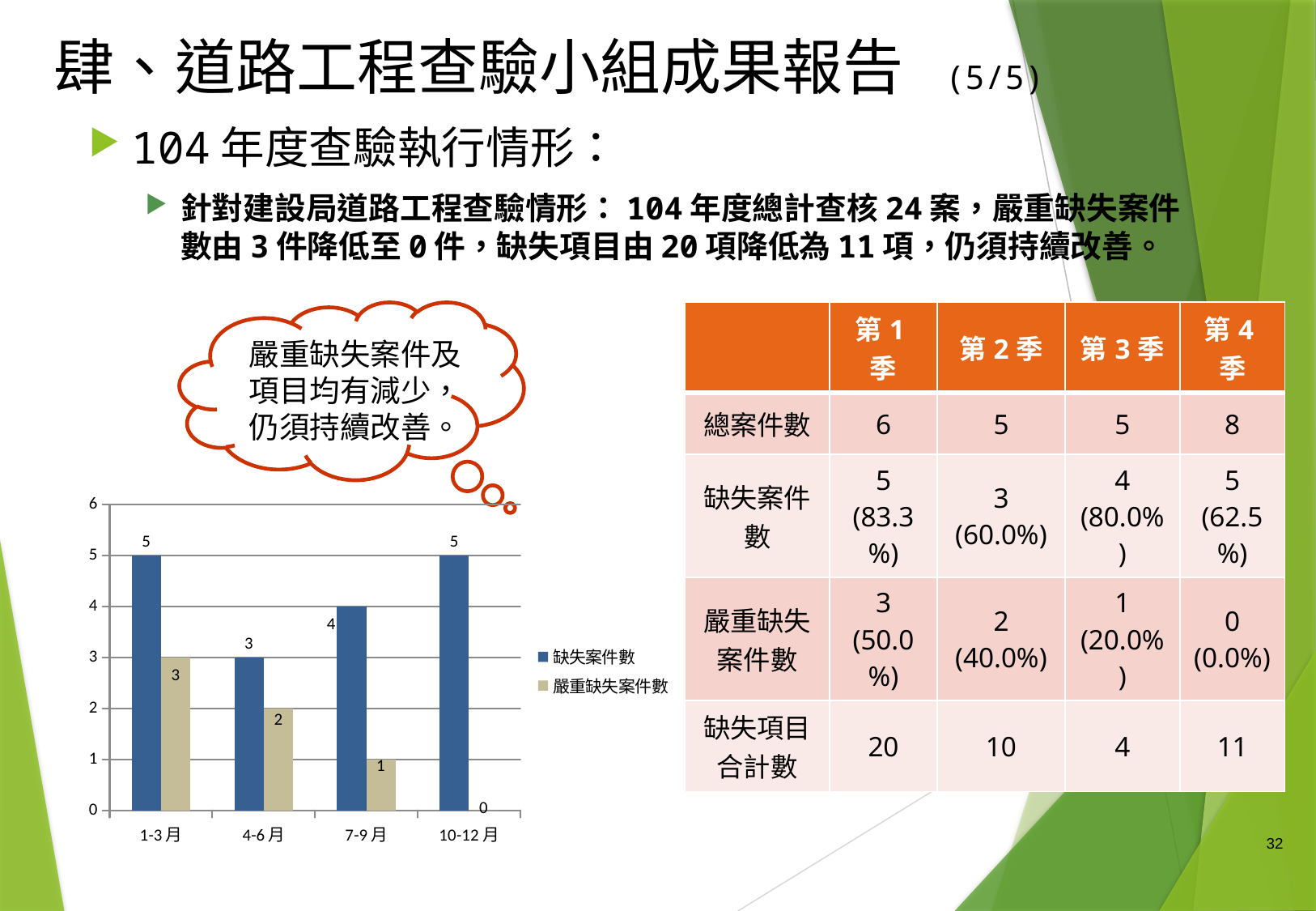
What is the value of 缺失案件數 for 7-9月? 4 Which is larger for 4-6月: 缺失案件數 or 嚴重缺失案件數? 缺失案件數 Which category has the highest value for 嚴重缺失案件數? 1-3月 How many series does the chart legend list? 2 What is the difference between 缺失案件數 and 嚴重缺失案件數 for 7-9月? 3 What kind of chart is shown on the slide? bar chart What is the value of 嚴重缺失案件數 for 4-6月? 2 What is the value of 嚴重缺失案件數 for 10-12月? 0 Do the values for 嚴重缺失案件數 rise or fall from 1-3月 to 10-12月? fall How many categories are shown on the x axis of the chart? 4 Which category has the lowest value for 缺失案件數? 4-6月 What is the value of 缺失案件數 for 1-3月? 5